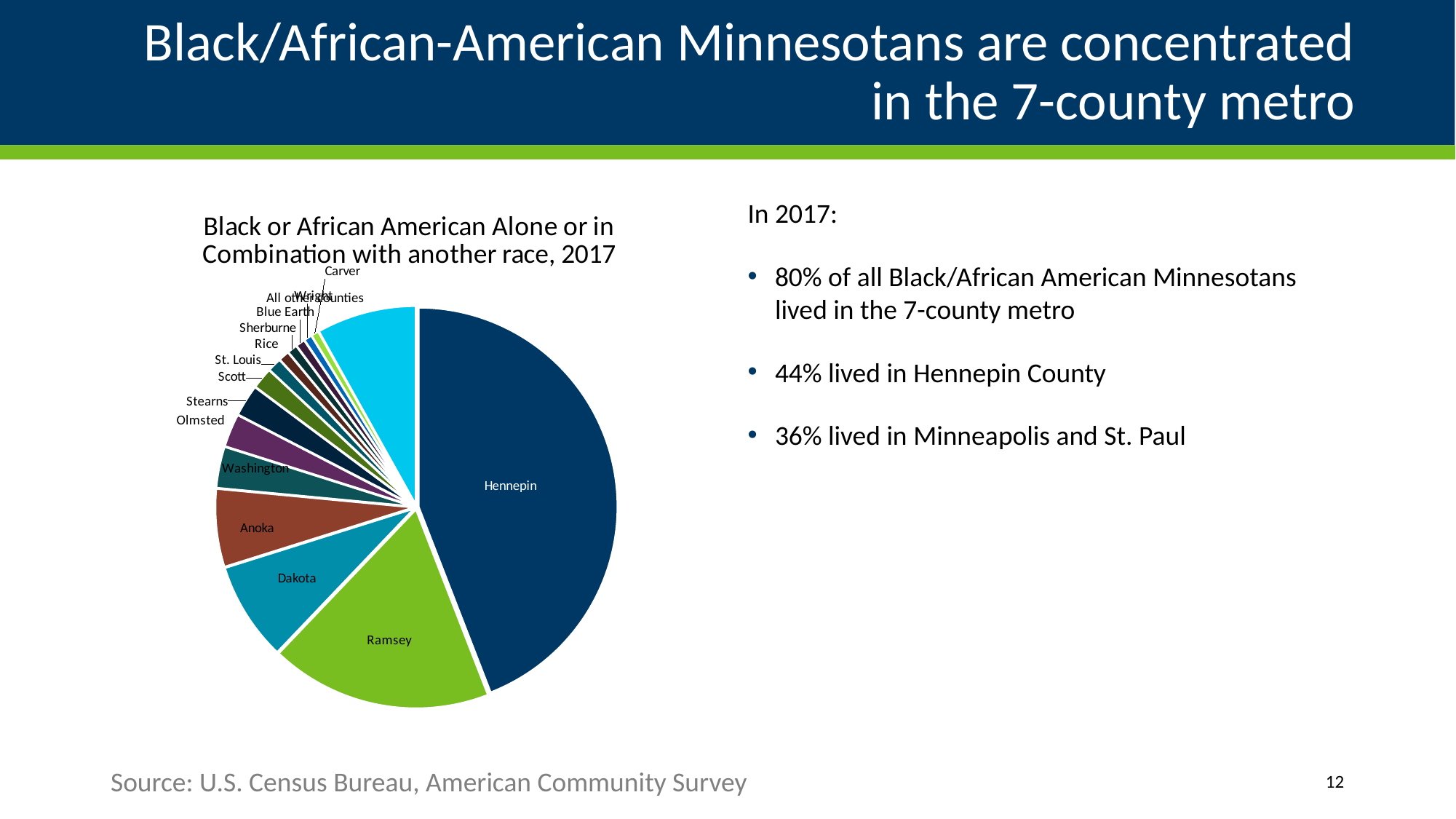
Which slice is larger, Dakota or Olmsted? Dakota What colour is the Hennepin slice of the pie chart? Dark blue What is the title of the pie chart? Black or African American Alone or in Combination with another race, 2017 Which slice is larger, Anoka or Washington? Anoka Which county has the second-largest slice of the pie chart? Ramsey Which slice is larger, Hennepin or Ramsey? Hennepin Which county has the largest slice of the pie chart? Hennepin What kind of chart is shown on the slide? Pie chart